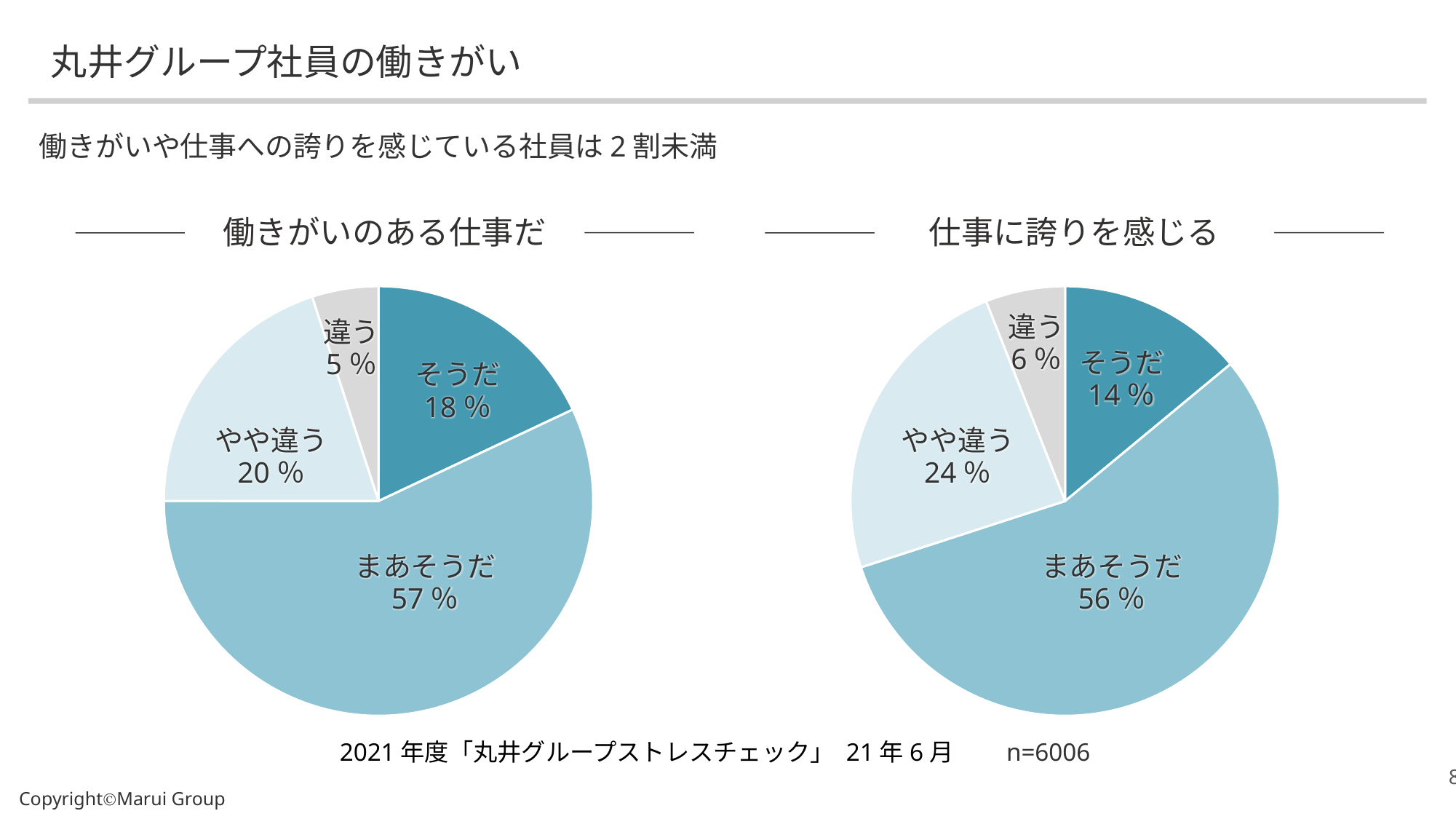
In the 働きがいのある仕事だ pie chart, what is the difference between the shares for まあそうだ and そうだ? 39 % In the 仕事に誇りを感じる pie chart, which category has the smallest share? 違う In the 働きがいのある仕事だ pie chart, which category has the largest share? まあそうだ What is the sample size (n) stated below the charts? n=6006 In the 仕事に誇りを感じる pie chart, what is the combined share of そうだ and まあそうだ? 70 % Which is larger: そうだ in the 働きがいのある仕事だ chart or そうだ in the 仕事に誇りを感じる chart? そうだ in the 働きがいのある仕事だ chart How many categories does the 仕事に誇りを感じる pie chart have? 4 In the 働きがいのある仕事だ pie chart, what percentage is shown for そうだ? 18 % In the 仕事に誇りを感じる pie chart, what percentage is shown for やや違う? 24 % What kind of chart is used for 働きがいのある仕事だ? Pie chart In the 働きがいのある仕事だ pie chart, which category has the smallest share? 違う In the 仕事に誇りを感じる pie chart, what percentage is shown for まあそうだ? 56 %